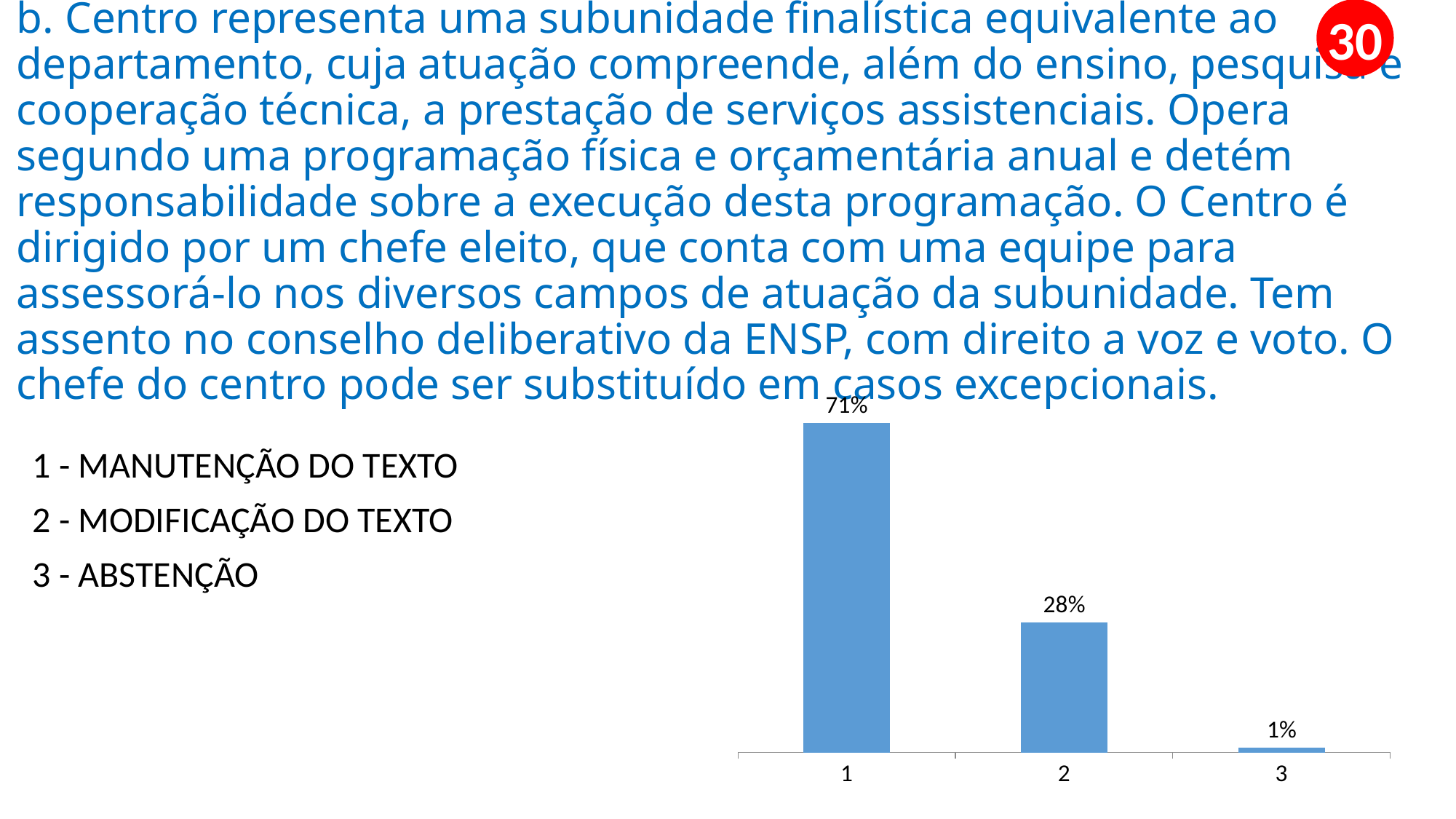
What is the value for category 2 in the chart? 28% How many categories are shown in the chart? 3 Which is larger, the value for category 1 or the value for category 2? 1 According to the key on the slide, what does category 3 in the chart stand for? ABSTENÇÃO Which category has the lowest value in the chart? 3 What is the value for category 1 in the chart? 71% What is the value for category 3 in the chart? 1% What is the difference between the values for category 1 and category 2? 43% Which category has the highest value in the chart? 1 Do the values rise or fall from category 1 to category 3? fall What is the difference between the values for category 2 and category 3? 27% What kind of chart is shown on the slide? bar chart